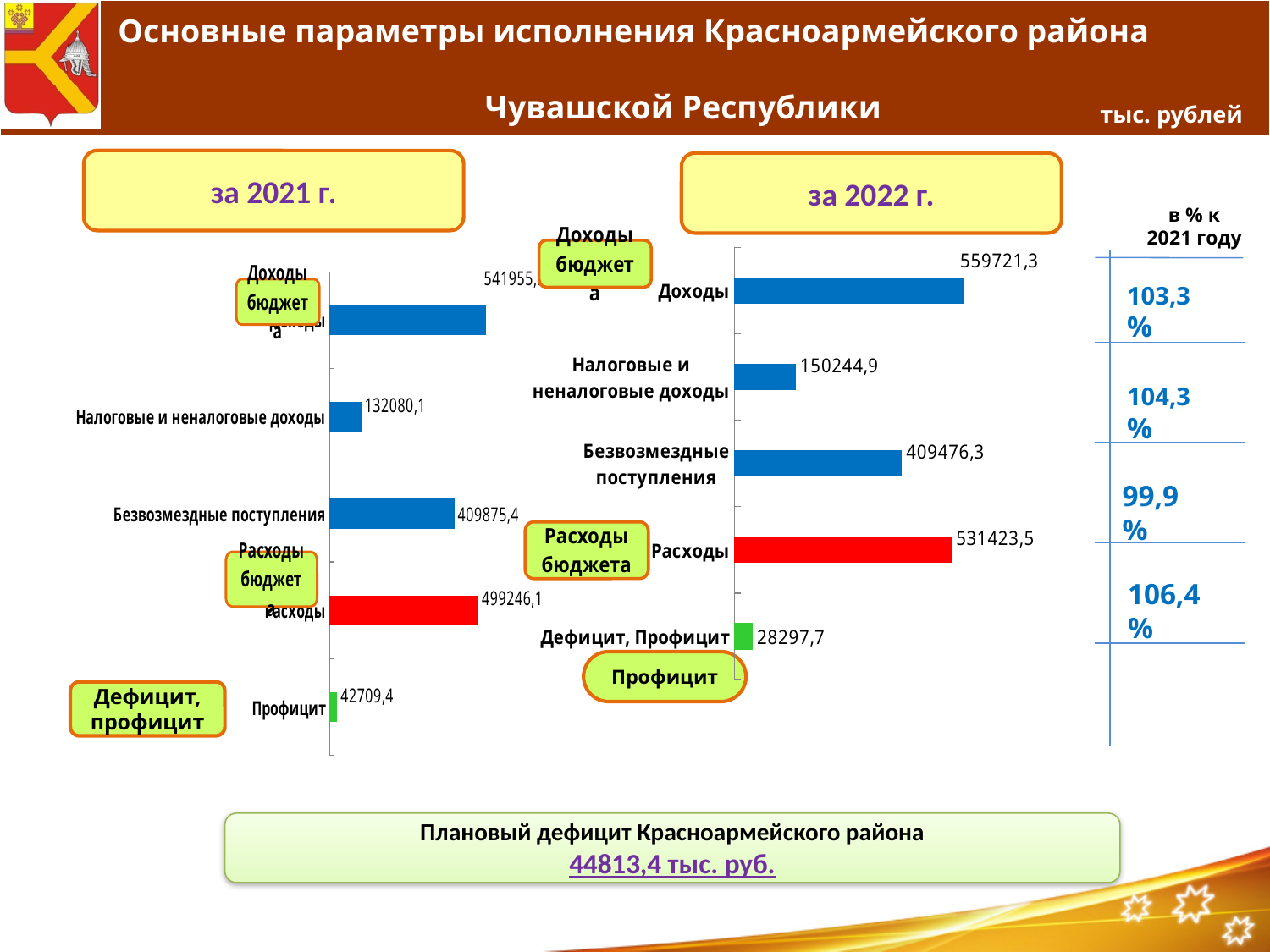
In the chart 'за 2021 г.', what is the value for Безвозмездные поступления? 409875,4 How many categories are shown in the chart 'за 2022 г.'? 5 Which is larger: Налоговые и неналоговые доходы in the chart 'за 2022 г.' or in the chart 'за 2021 г.'? за 2022 г. In the chart 'за 2022 г.', what is the value for Дефицит, Профицит? 28297,7 In the chart 'за 2022 г.', which category has the highest value? Доходы What is the difference between Расходы in the chart 'за 2022 г.' and Расходы in the chart 'за 2021 г.'? 32177,4 In the chart 'за 2022 г.', what is the difference between Безвозмездные поступления and Налоговые и неналоговые доходы? 259231,4 In the chart 'за 2021 г.', what is the value for Расходы? 499246,1 In the chart 'за 2021 г.', which category has the lowest value? Профицит What type of chart is the chart 'за 2021 г.'? bar chart In the chart 'за 2022 г.', what is the value for Налоговые и неналоговые доходы? 150244,9 In the chart 'за 2022 г.', what is the value for Доходы? 559721,3